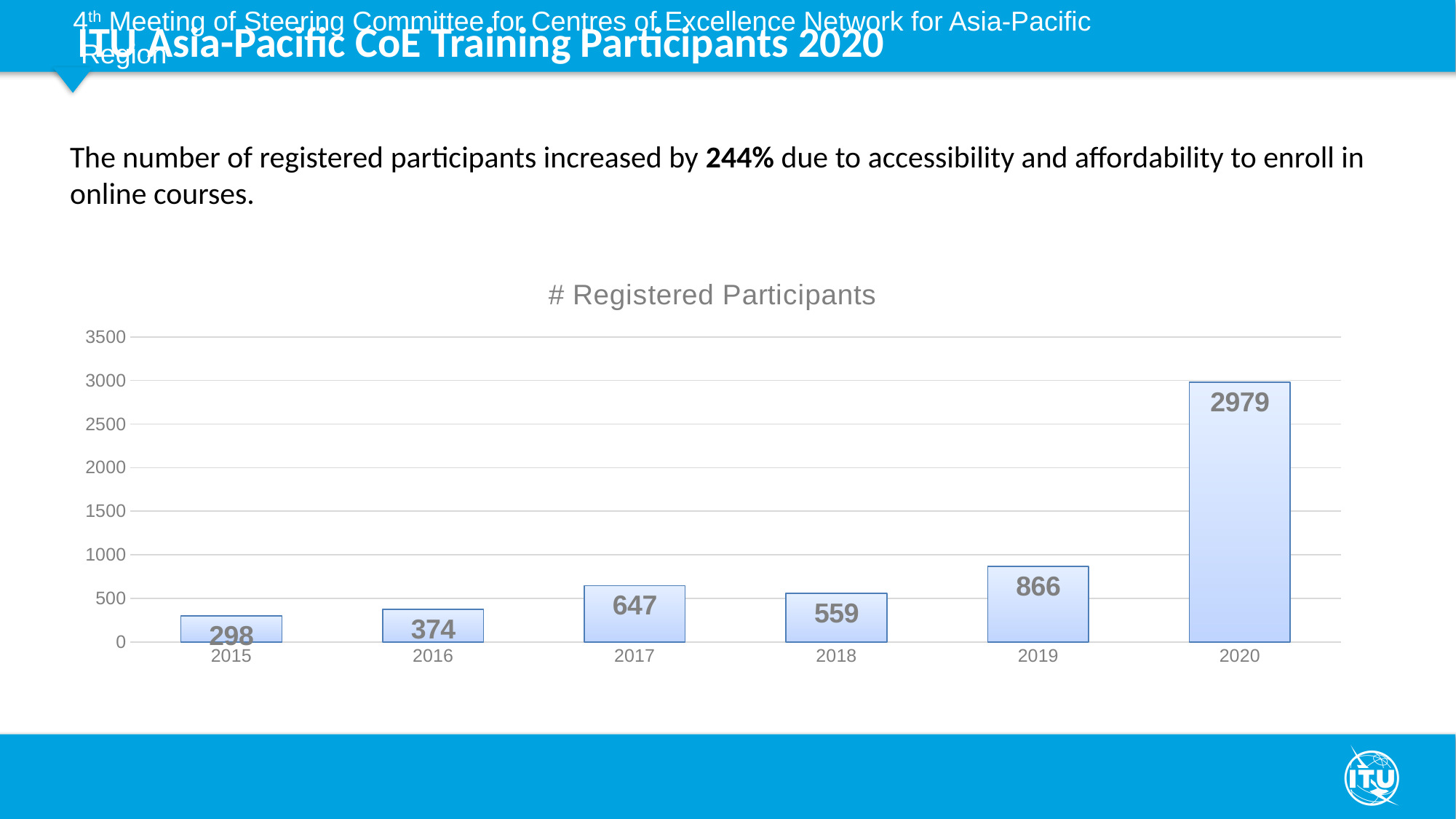
What is the difference in registered participants between 2017 and 2018? 88 What kind of chart is shown on the slide? bar chart Which year has the lowest number of registered participants? 2015 What is the number of registered participants in 2020? 2979 Is the value for 2019 greater or less than 1000? less Which year has the highest number of registered participants? 2020 What is the number of registered participants in 2015? 298 What is the difference in registered participants between 2020 and 2019? 2113 How many years are shown on the x axis of the chart? 6 What is the number of registered participants in 2018? 559 What is the title of the chart? # Registered Participants Which year had more registered participants, 2017 or 2018? 2017